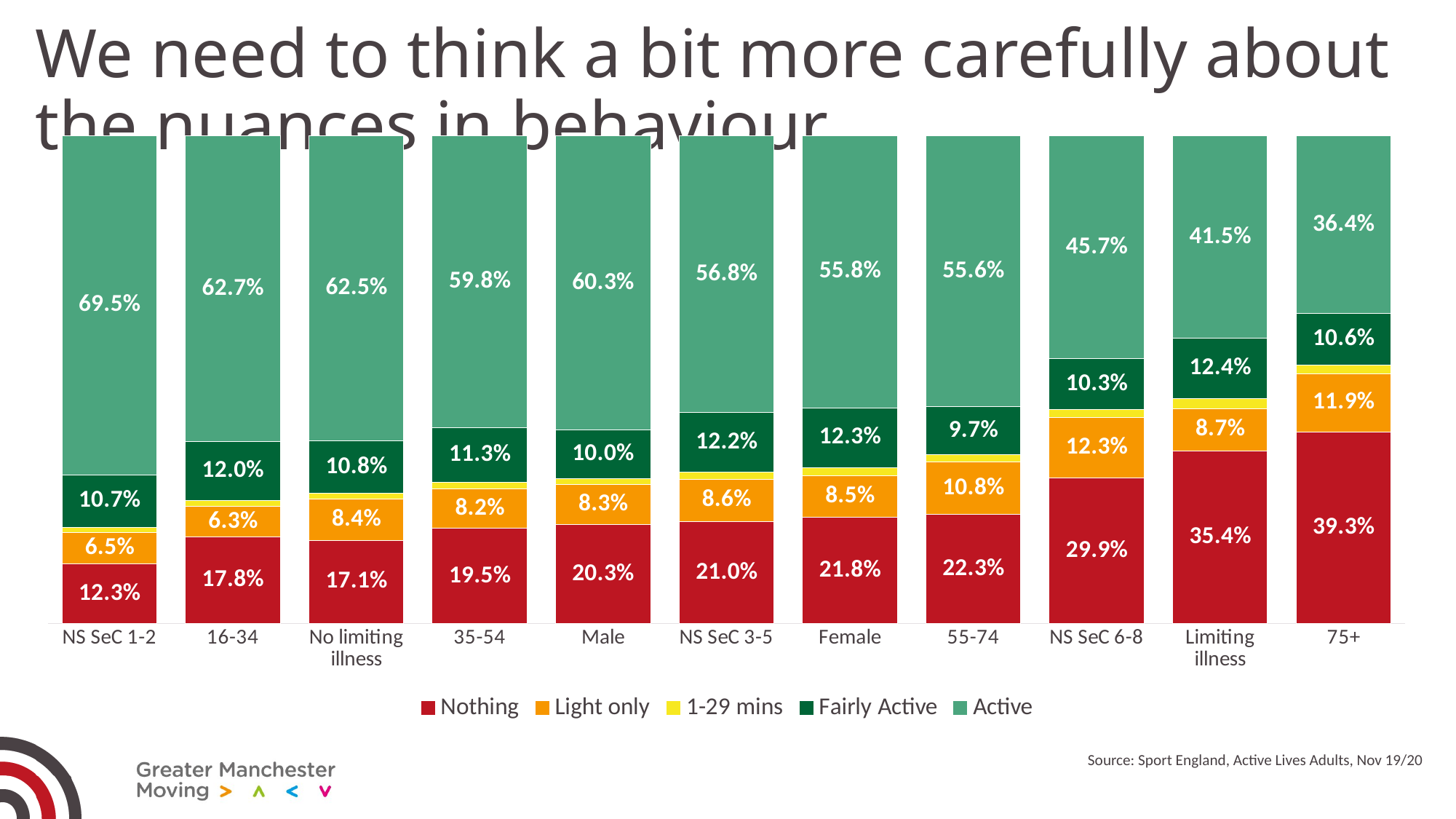
Which category has the highest Nothing share? 75+ What is the Light only value for NS SeC 6-8? 12.3% How many categories are shown along the x axis? 11 What kind of chart is shown on the slide? Stacked bar chart What is the Active share for NS SeC 1-2? 69.5% How many series does the legend list? 5 What is the Fairly Active value for Female? 12.3% Which category has the highest Active share? NS SeC 1-2 What is the difference between the Active shares for Male and Female? 4.5% What percentage of the 75+ group is in the Nothing category? 39.3% Which category has the lowest Nothing share? NS SeC 1-2 Which is larger, the Nothing share for Limiting illness or for No limiting illness? Limiting illness